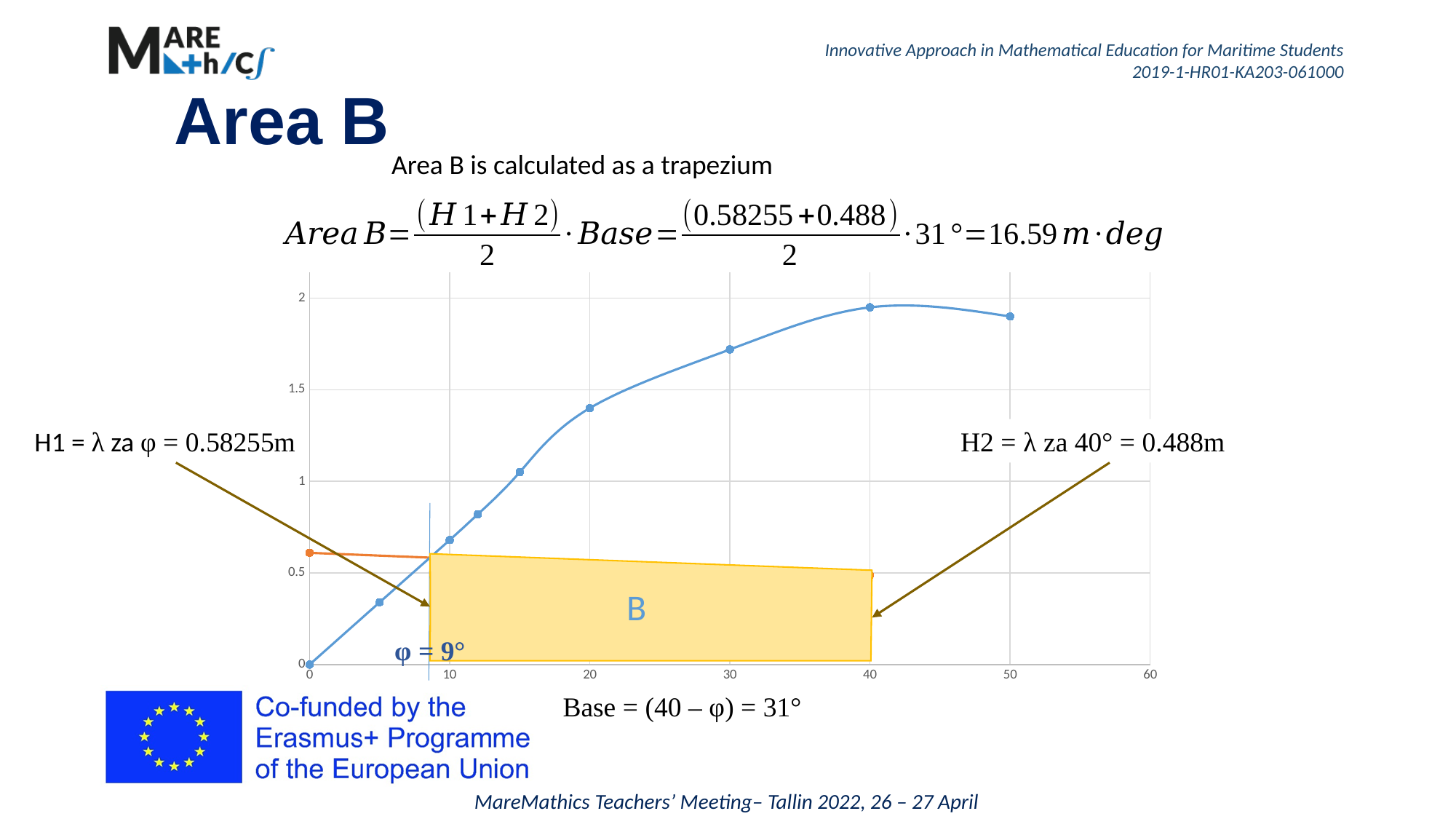
What is the Base of the trapezium B as stated below the chart? 31° According to the annotation, what is the value of H2 (λ at 40°)? 0.488m Is the value of the blue curve at x = 20 greater or less than 1.5? less Is the value of the blue curve at x = 5 greater or less than 0.5? less What letter labels the shaded trapezium region on the chart? B Which is larger on the blue curve, the value at x = 30 or the value at x = 20? x = 30 What kind of chart is shown on the slide? line chart Is the value of the blue curve at x = 30 greater or less than 1.5? greater Does the blue curve rise or fall between x = 0 and x = 40? rise How many data points are marked on the blue curve? 9 According to the annotation, what is the value of H1 (λ at φ)? 0.58255m